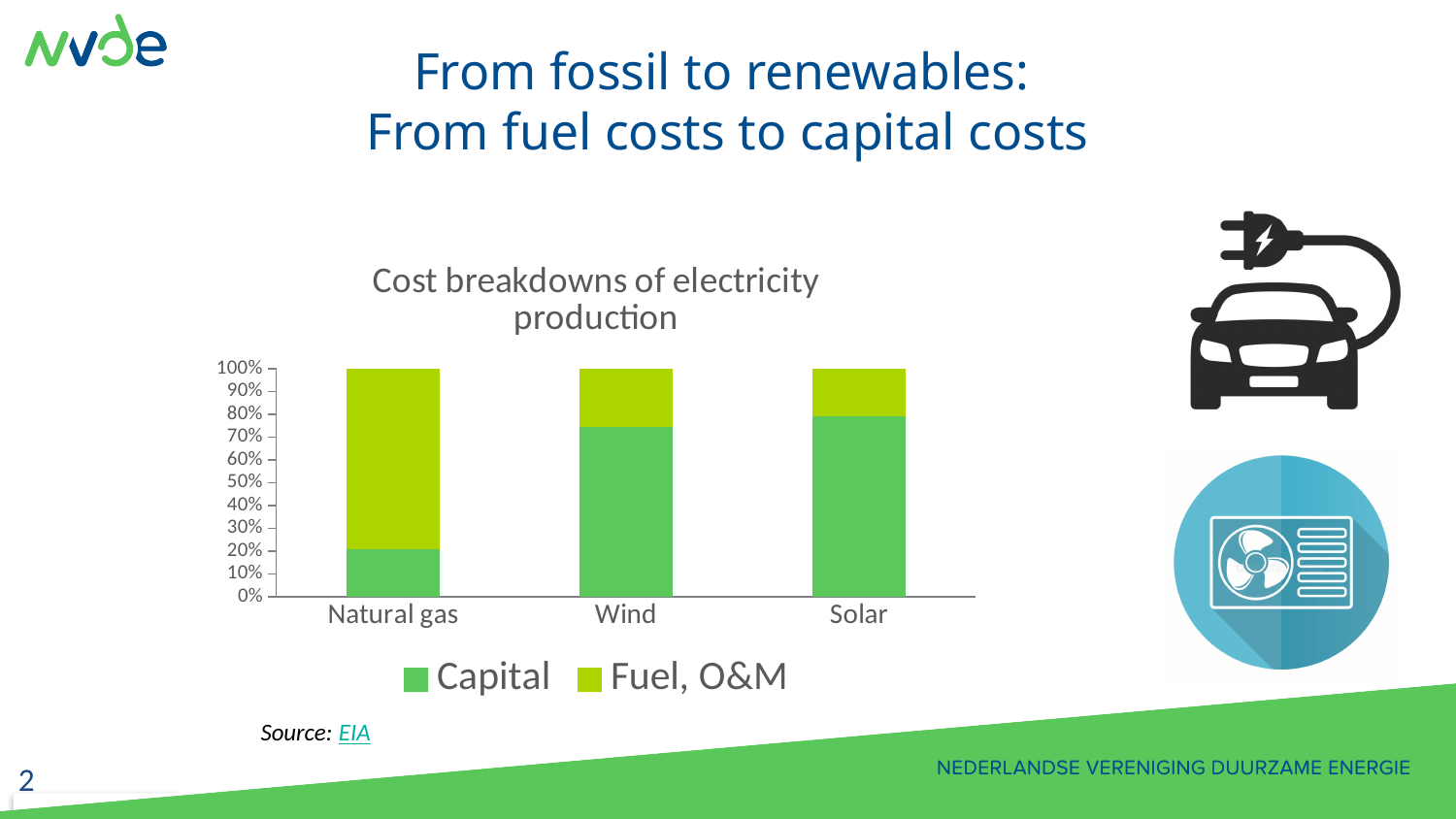
What is the title of the chart? Cost breakdowns of electricity production Is the Capital share for Wind greater or less than 90%? less How many series does the legend list? 2 Is the Capital share for Wind greater or less than 60%? greater Which is larger, the Capital share for Wind or the Capital share for Natural gas? Wind Is the Capital share for Solar greater or less than 70%? greater Which series is shown in the lighter yellow-green colour in the legend? Fuel, O&M What kind of chart is shown on the slide? Stacked bar chart Which category has the smallest Capital share? Natural gas Which category has the largest Fuel, O&M share? Natural gas How many categories are shown on the x axis? 3